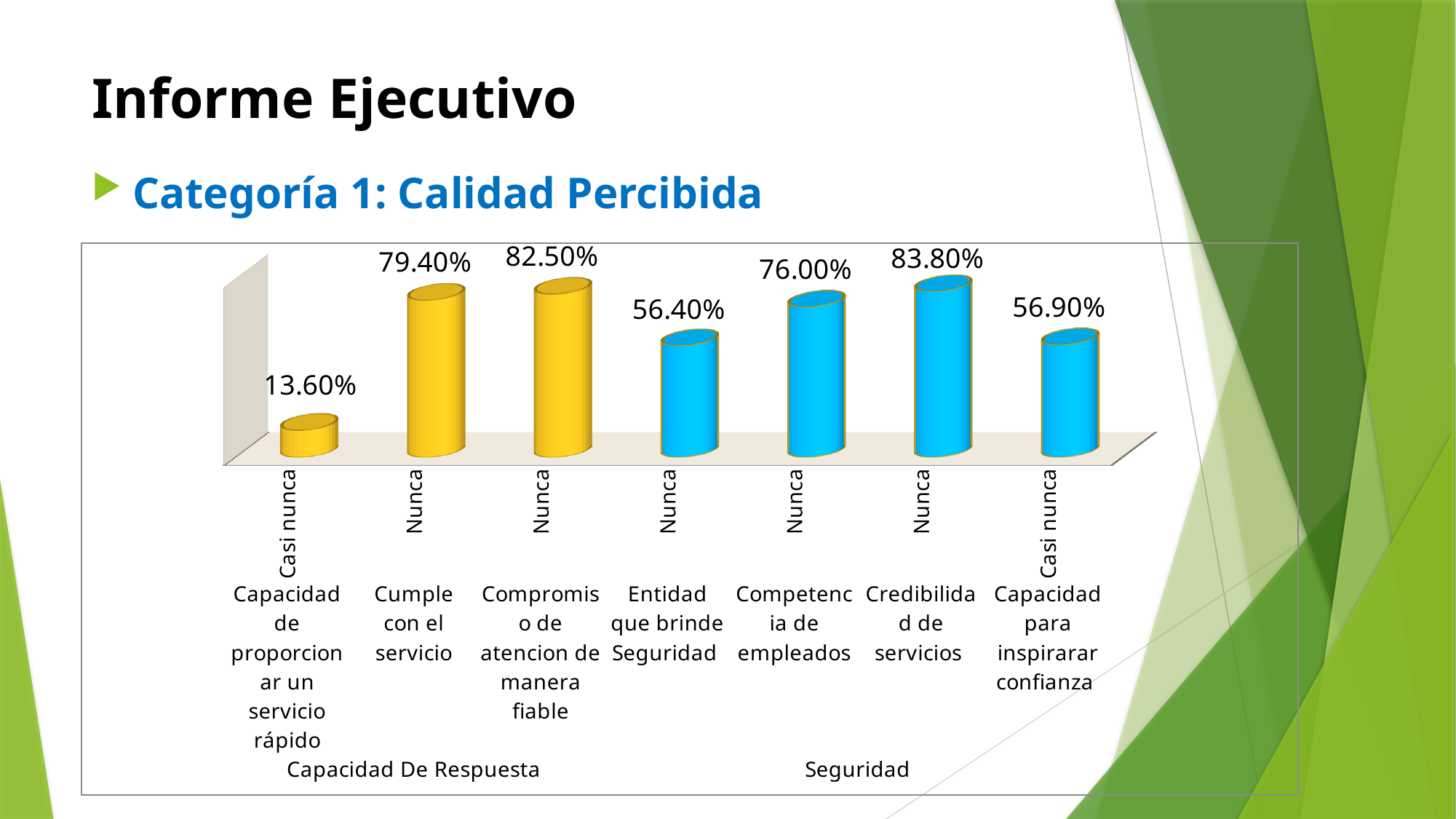
What response label is shown under the bar for "Capacidad para inspirarar confianza"? Casi nunca What are the two group labels shown along the bottom of the chart? Capacidad De Respuesta and Seguridad Which is larger, the value for "Capacidad para inspirarar confianza" or the value for "Entidad que brinde Seguridad"? Capacidad para inspirarar confianza What is the value for "Capacidad de proporcionar un servicio rápido"? 13.60% How many bars are plotted in the chart? 7 Which category has the lowest value? Capacidad de proporcionar un servicio rápido Which category has the highest value? Credibilidad de servicios What is the value for "Entidad que brinde Seguridad"? 56.40% What kind of chart is shown on the slide? Bar chart What is the value for "Cumple con el servicio"? 79.40% What is the value for "Credibilidad de servicios"? 83.80% What is the difference between the values for "Compromiso de atencion de manera fiable" and "Competencia de empleados"? 6.50%